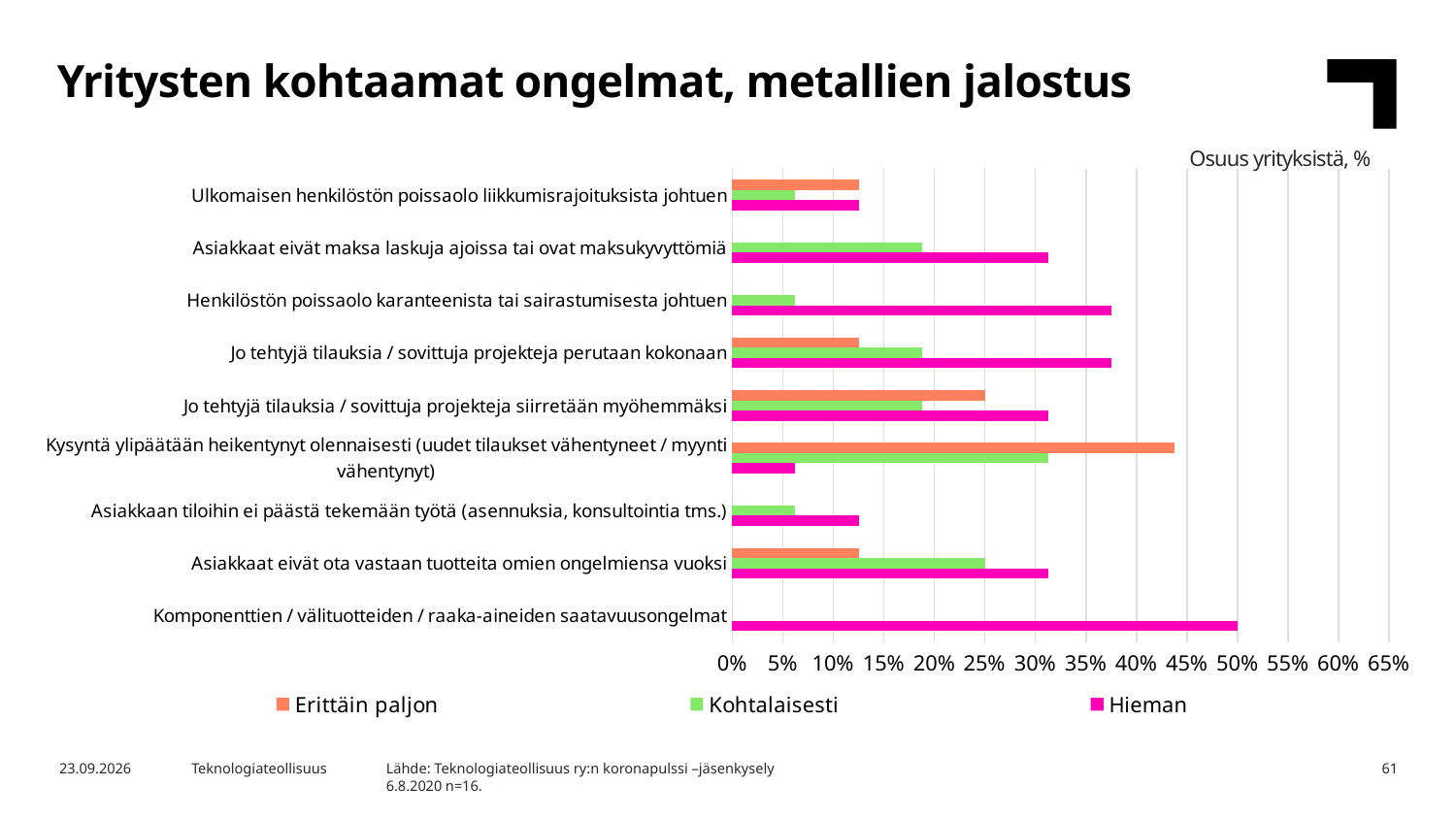
Which category has the highest 'Hieman' value? Komponenttien / välituotteiden / raaka-aineiden saatavuusongelmat For 'Kysyntä ylipäätään heikentynyt olennaisesti', which is larger: the 'Erittäin paljon' value or the 'Hieman' value? Erittäin paljon How many problem categories are plotted on the chart? 9 How many series does the legend list? 3 What is the title of the chart on the slide? Yritysten kohtaamat ongelmat, metallien jalostus What is the 'Hieman' value for 'Komponenttien / välituotteiden / raaka-aineiden saatavuusongelmat'? 50% What kind of chart is shown on the slide? Bar chart Is the 'Erittäin paljon' value for 'Kysyntä ylipäätään heikentynyt olennaisesti' greater or less than 40%? greater What is the 'Erittäin paljon' value for 'Jo tehtyjä tilauksia / sovittuja projekteja siirretään myöhemmäksi'? 25% Is the 'Hieman' value for 'Henkilöstön poissaolo karanteenista tai sairastumisesta johtuen' greater or less than 35%? greater Which category has the highest 'Erittäin paljon' value? Kysyntä ylipäätään heikentynyt olennaisesti (uudet tilaukset vähentyneet / myynti vähentynyt) Is the 'Kohtalaisesti' value for 'Ulkomaisen henkilöstön poissaolo liikkumisrajoituksista johtuen' greater or less than 10%? less